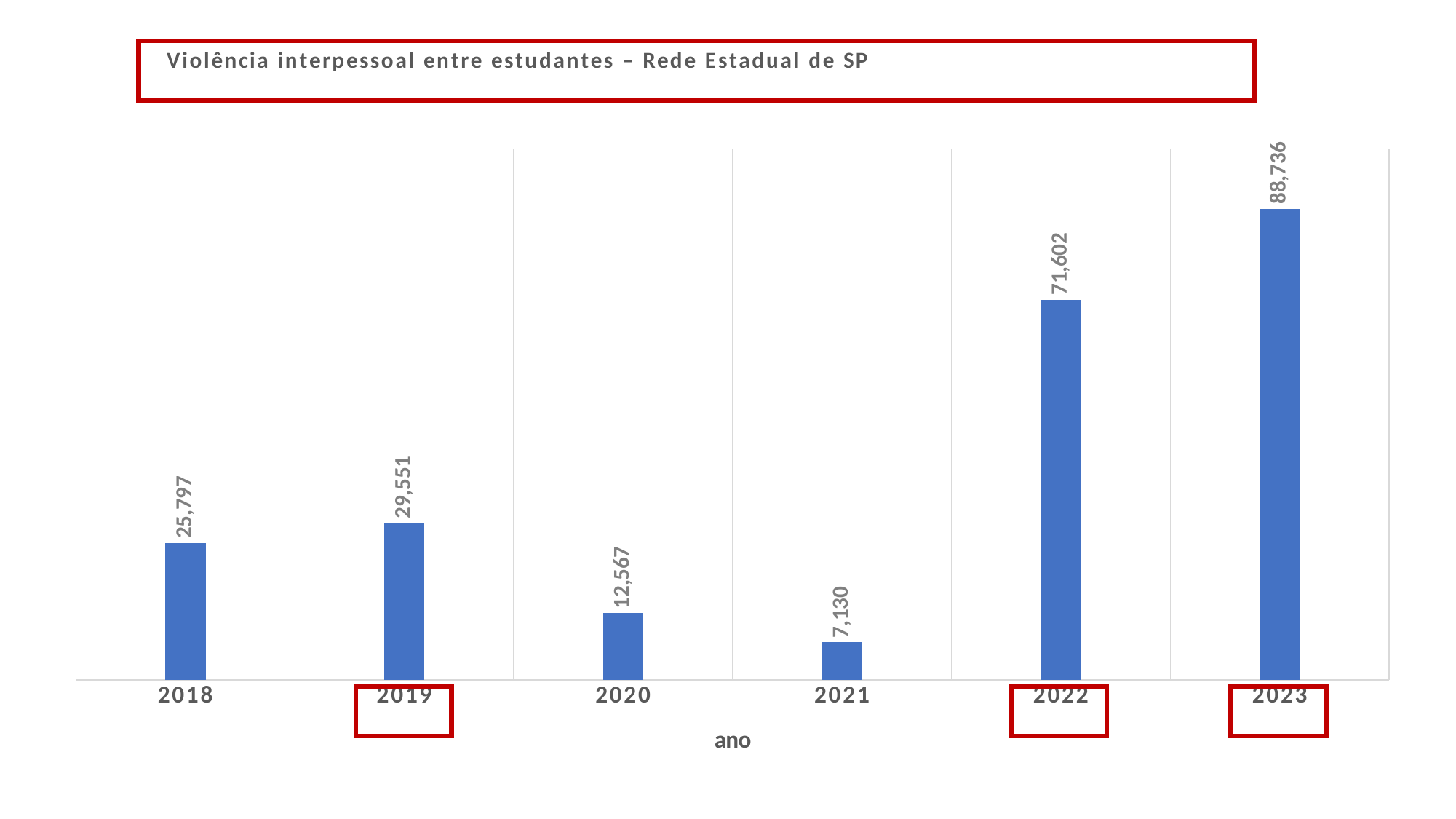
What is the difference between the values for 2019 and 2018? 3,754 Which year has the lowest value? 2021 What is the value for 2020? 12,567 What is the difference between the values for 2023 and 2022? 17,134 Which is larger, the value for 2020 or the value for 2021? 2020 What is the value for 2018? 25,797 What is the value for 2021? 7,130 Which year has the highest value? 2023 What kind of chart is shown on the slide? Bar chart What is the value for 2023? 88,736 Do the values rise or fall from 2021 to 2023? Rise How many years are shown on the x axis? 6